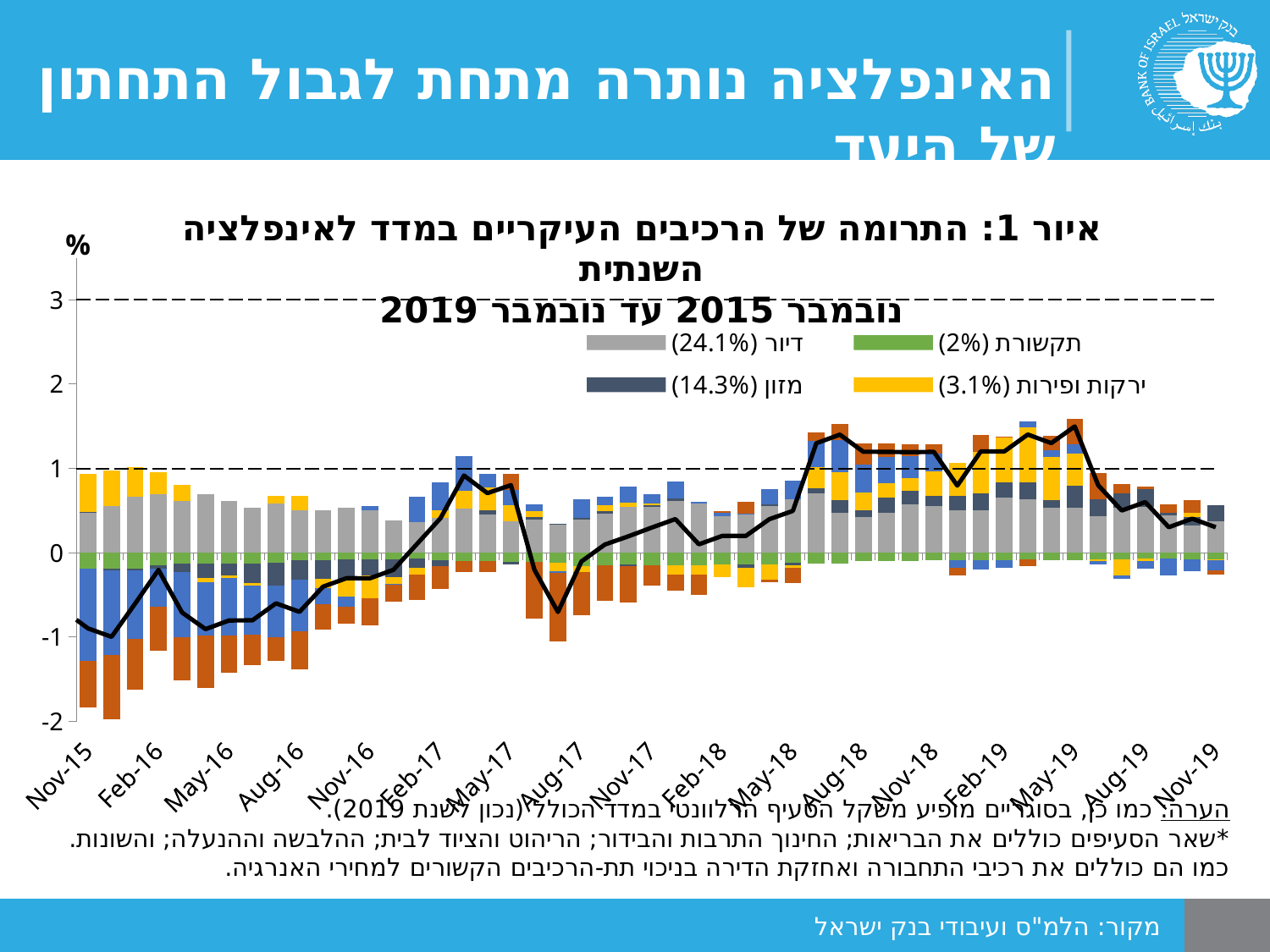
What type of chart is shown on the slide? Stacked bar chart with a line Is the value of the line at Feb-16 greater or less than 0? less Is the value of the line at Nov-15 greater or less than 0? less What percentage is shown next to דיור in the legend? 24.1% What is the highest value marked on the y axis? 3 Is the value of the line at Nov-19 greater or less than 1? less Which is larger, the value of the line at May-19 or at Nov-15? May-19 How many date labels are shown along the x axis? 17 Which is larger, the value of the line at Aug-18 or at Feb-16? Aug-18 Does the line overall rise or fall from Nov-15 to Nov-19? rise